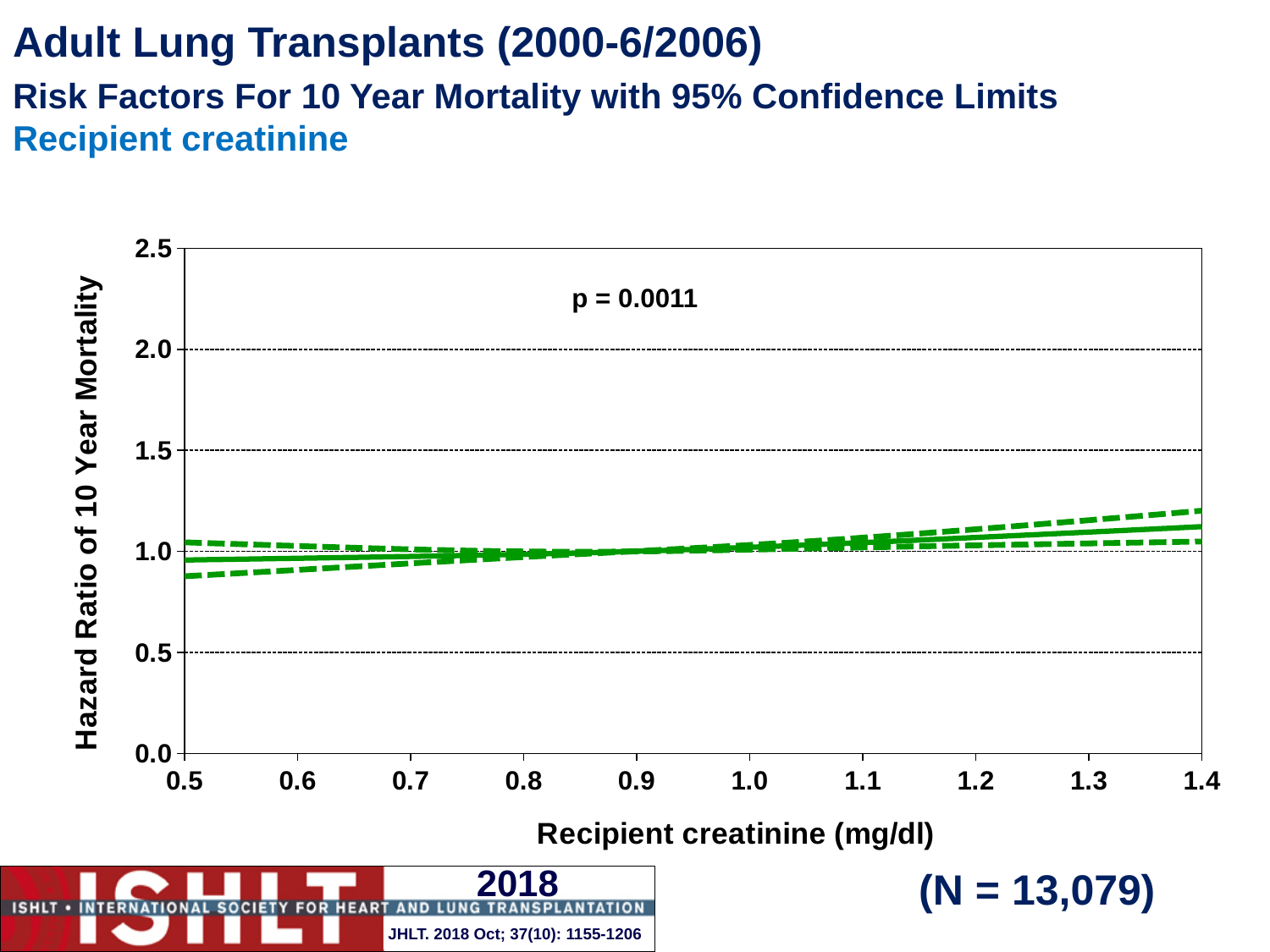
Is the hazard ratio at a recipient creatinine of 0.5 mg/dl greater or less than 0.5? greater What p-value is printed on the chart? p = 0.0011 Does the hazard ratio rise or fall as recipient creatinine increases from 0.5 to 1.4 mg/dl? rise What is the label of the x axis? Recipient creatinine (mg/dl) What kind of chart is shown on the slide? line chart Is the hazard ratio at a recipient creatinine of 1.4 mg/dl greater or less than 1.5? less Is the hazard ratio at a recipient creatinine of 1.4 mg/dl greater or less than 1.0? greater What colour are the plotted lines? green What is the highest value shown on the y axis? 2.5 What sample size (N) is shown on the slide? N = 13,079 How many lines are plotted on the chart (the estimate plus its confidence limits)? 3